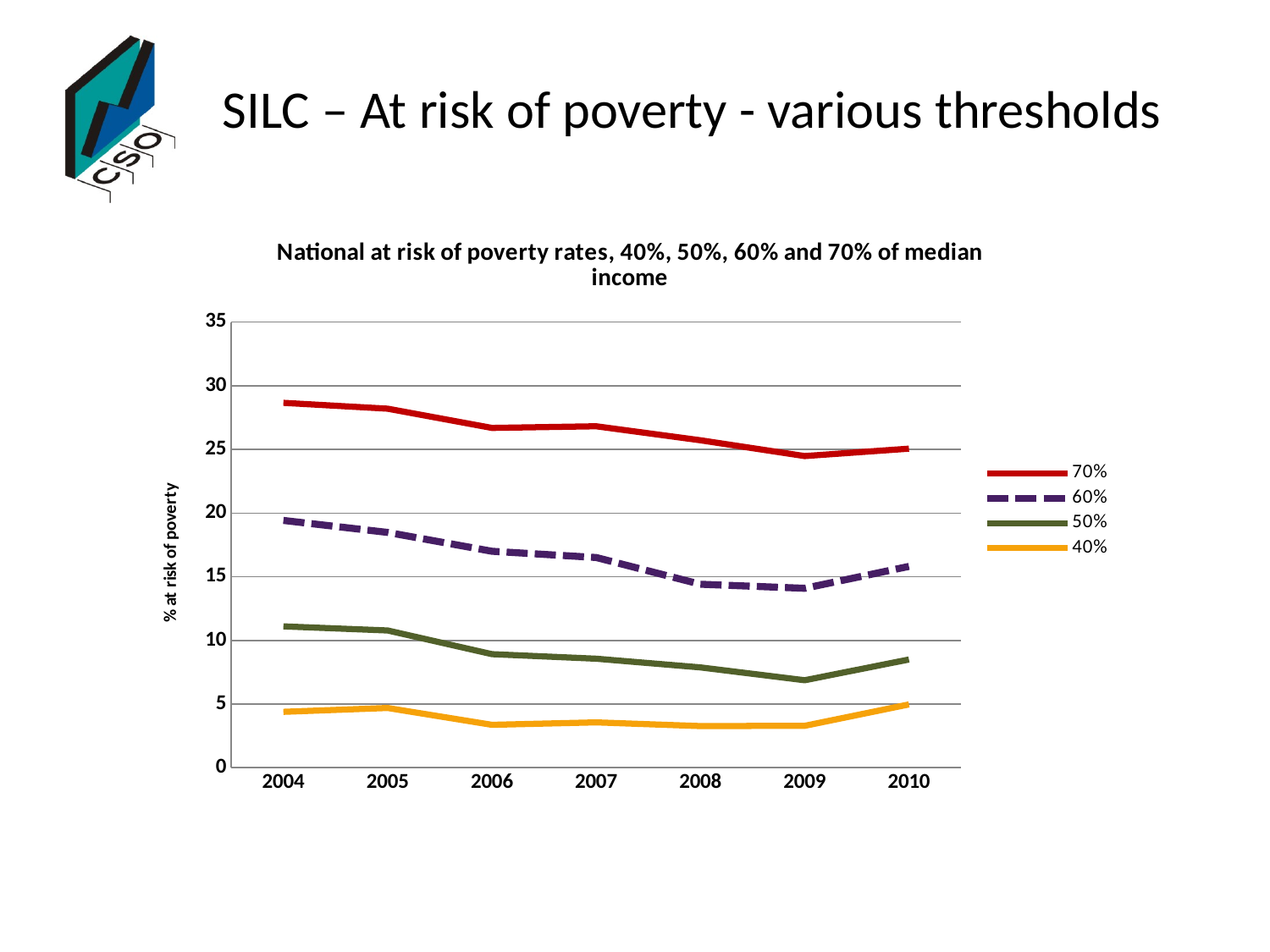
Is the value for the 60% series in 2004 greater or less than 15? greater What kind of chart is shown on the slide? line chart Is the value for the 40% series in 2006 greater or less than 5? less How many series does the legend list? 4 Is the value for the 70% series in 2004 greater or less than 25? greater In which year is the 70% series at its highest? 2004 In which year is the 50% series at its lowest? 2009 Which series is drawn with a dashed line? 60% How many years are plotted along the x axis? 7 Does the 70% series rise or fall from 2004 to 2009? fall Which is larger for the 60% series: the value in 2004 or the value in 2010? 2004